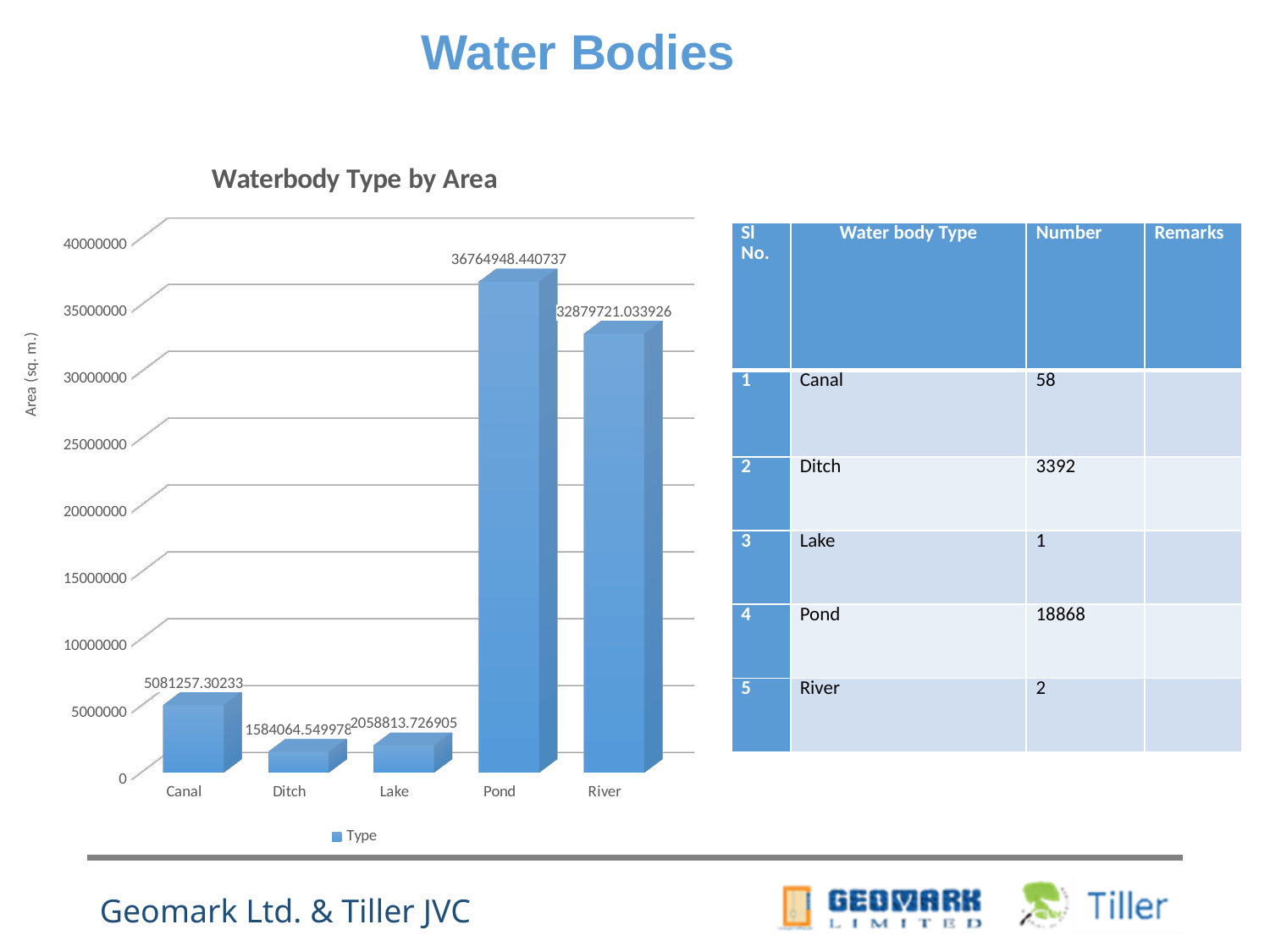
What is the difference between the Pond and River values in the chart? 3885227.406811 What is the value for Pond in the Waterbody Type by Area chart? 36764948.440737 What is the difference between the Lake and Ditch values in the chart? 474749.176927 How many waterbody types are shown on the x axis of the chart? 5 What is the value for Canal in the Waterbody Type by Area chart? 5081257.30233 What kind of chart is Waterbody Type by Area? bar chart What is the value for River in the Waterbody Type by Area chart? 32879721.033926 Is the value for River in the chart greater or less than 30000000? greater Which waterbody type has the largest area in the chart? Pond Which waterbody type has the smallest area in the chart? Ditch Which is larger in the chart, the value for Canal or the value for Lake? Canal What is the value for Ditch in the Waterbody Type by Area chart? 1584064.549978